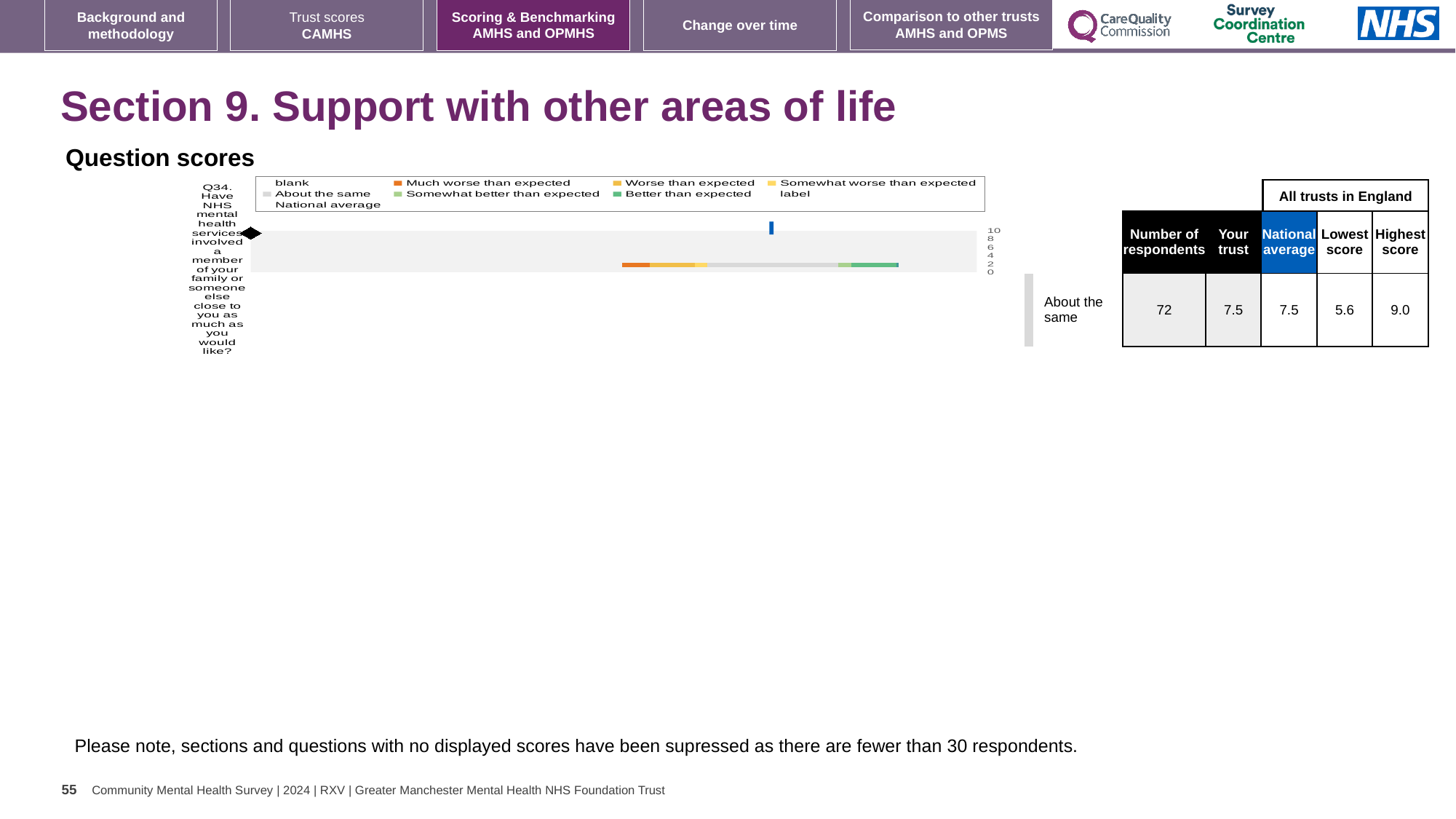
According to the table beside the Question scores chart, what is the lowest score among all trusts in England for Q34? 5.6 According to the table beside the Question scores chart, how many respondents answered Q34? 72 How many questions (categories) are plotted in the Question scores chart? 1 According to the table beside the Question scores chart, what is the 'Your trust' score for Q34? 7.5 What benchmark category is shown next to the Q34 bar in the Question scores chart? About the same What kind of chart is shown under 'Question scores'? bar chart According to the table beside the Question scores chart, what is the highest score among all trusts in England for Q34? 9.0 What is the highest value shown on the score axis of the Question scores chart? 10 What colour does the legend use for 'Much worse than expected' in the Question scores chart? orange According to the table beside the Question scores chart, what is the national average score for Q34? 7.5 According to the table beside the Question scores chart, what is the difference between the highest and lowest scores for Q34? 3.4 Which question number is plotted in the Question scores chart? Q34